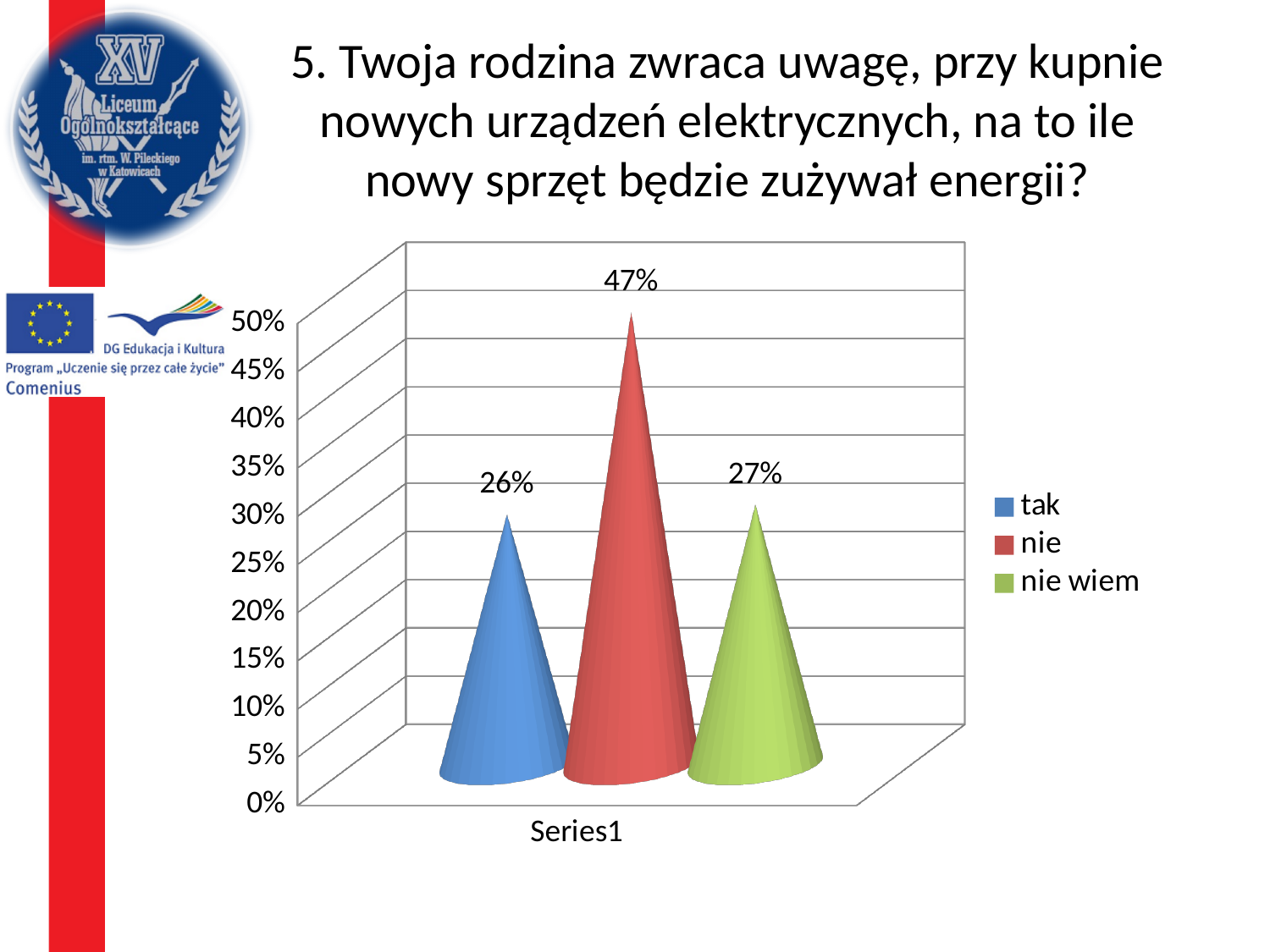
What is the value for "nie"? 47% Which is larger, the value for "nie" or the value for "nie wiem"? nie What is the value for "nie wiem"? 27% What colour is the bar for "nie"? red What is the difference between the values for "nie wiem" and "tak"? 1% Is the value for "nie" greater or less than 40%? greater What is the difference between the values for "nie" and "tak"? 21% What is the value for "tak"? 26% Which answer has the lowest value? tak How many series does the legend list? 3 Which answer has the highest value? nie What kind of chart is shown on the slide? bar chart